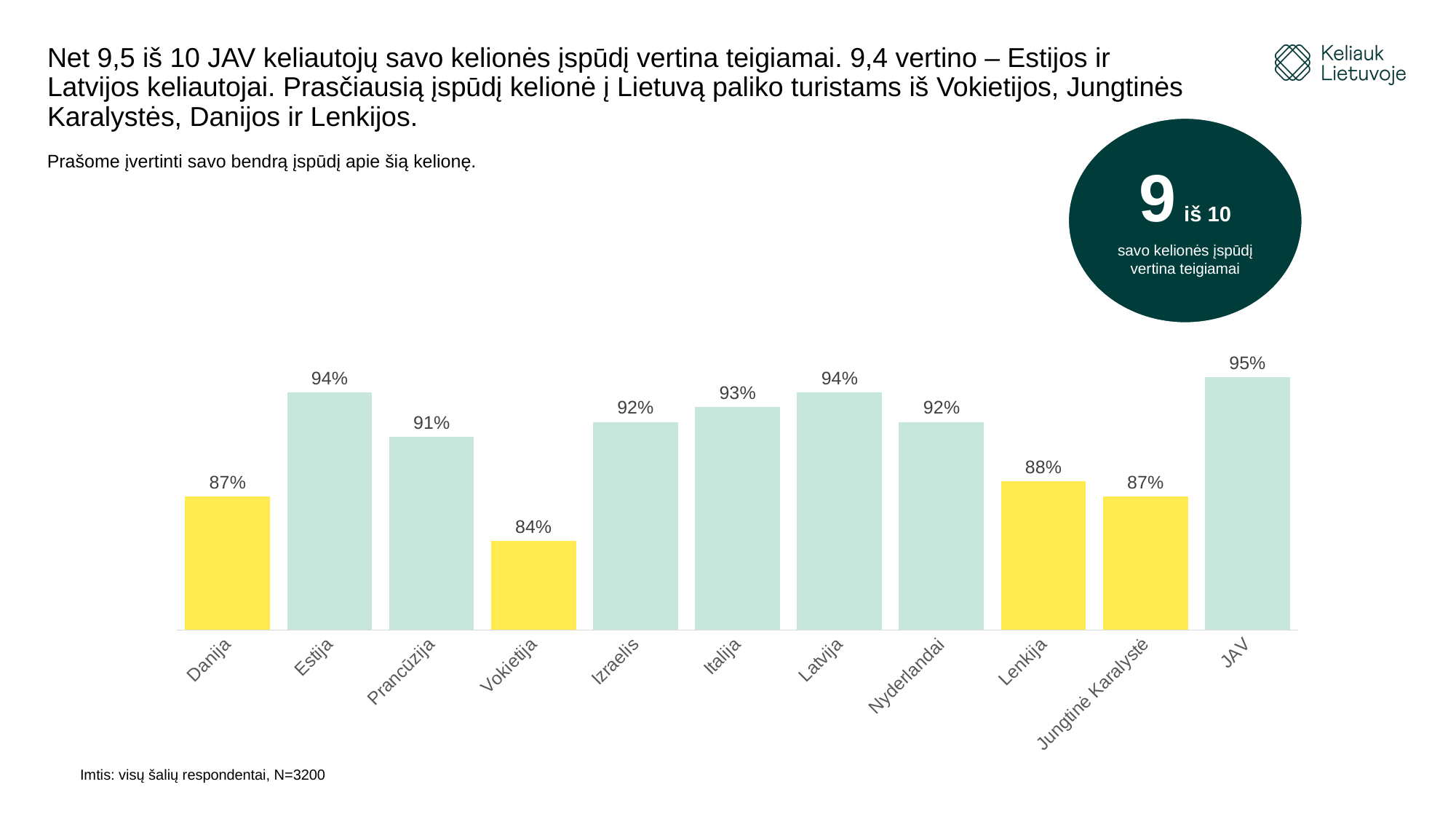
What is the difference between the values for JAV and Vokietija? 11% What is the value for JAV? 95% How many bars are highlighted in yellow? 4 How many countries are shown in the chart? 11 Which countries have a value of 94%? Estija and Latvija What kind of chart is shown on the slide? bar chart What is the value for Prancūzija? 91% Which country has the highest value? JAV What is the value for Vokietija? 84% What is the difference between the values for Estija and Lenkija? 6% Which is larger, the value for Italija or the value for Nyderlandai? Italija Which country has the lowest value? Vokietija